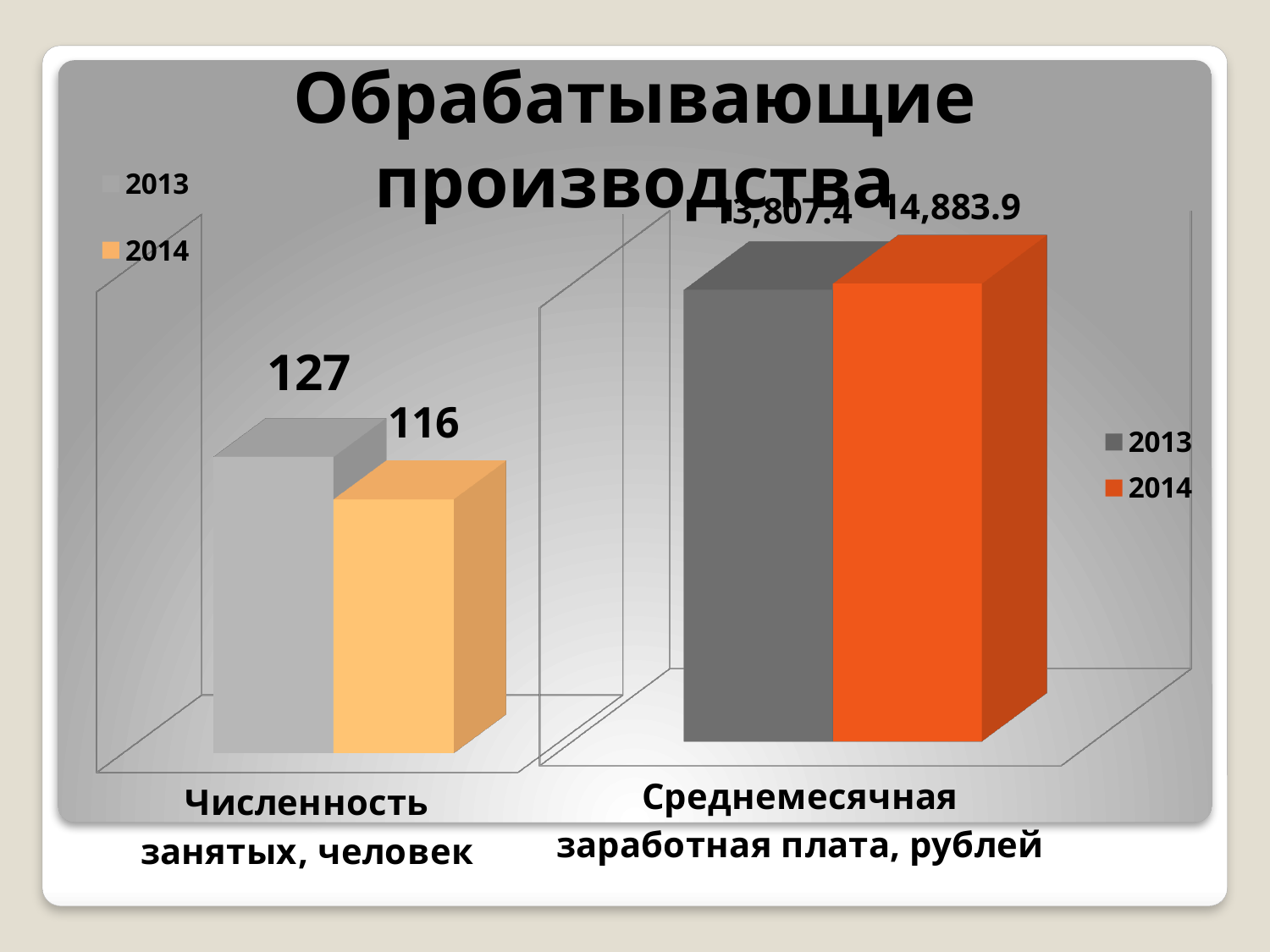
How many series does the legend of the right chart (Среднемесячная заработная плата, рублей) list? 2 On the left chart (Численность занятых, человек), which year has the lower value? 2014 What kind of chart is the left chart (Численность занятых, человек)? bar chart On the left chart (Численность занятых, человек), what is the value for 2014? 116 On the left chart (Численность занятых, человек), do the values rise or fall from 2013 to 2014? fall On the left chart (Численность занятых, человек), what is the difference between the 2013 and 2014 values? 11 On the right chart (Среднемесячная заработная плата, рублей), which year has the higher value? 2014 On the right chart (Среднемесячная заработная плата, рублей), is the value for 2013 larger or smaller than the value for 2014? smaller On the right chart (Среднемесячная заработная плата, рублей), what is the value for 2014? 14,883.9 On the left chart (Численность занятых, человек), which year has the higher value? 2013 On the left chart (Численность занятых, человек), what is the value for 2013? 127 On the right chart (Среднемесячная заработная плата, рублей), do the values rise or fall from 2013 to 2014? rise